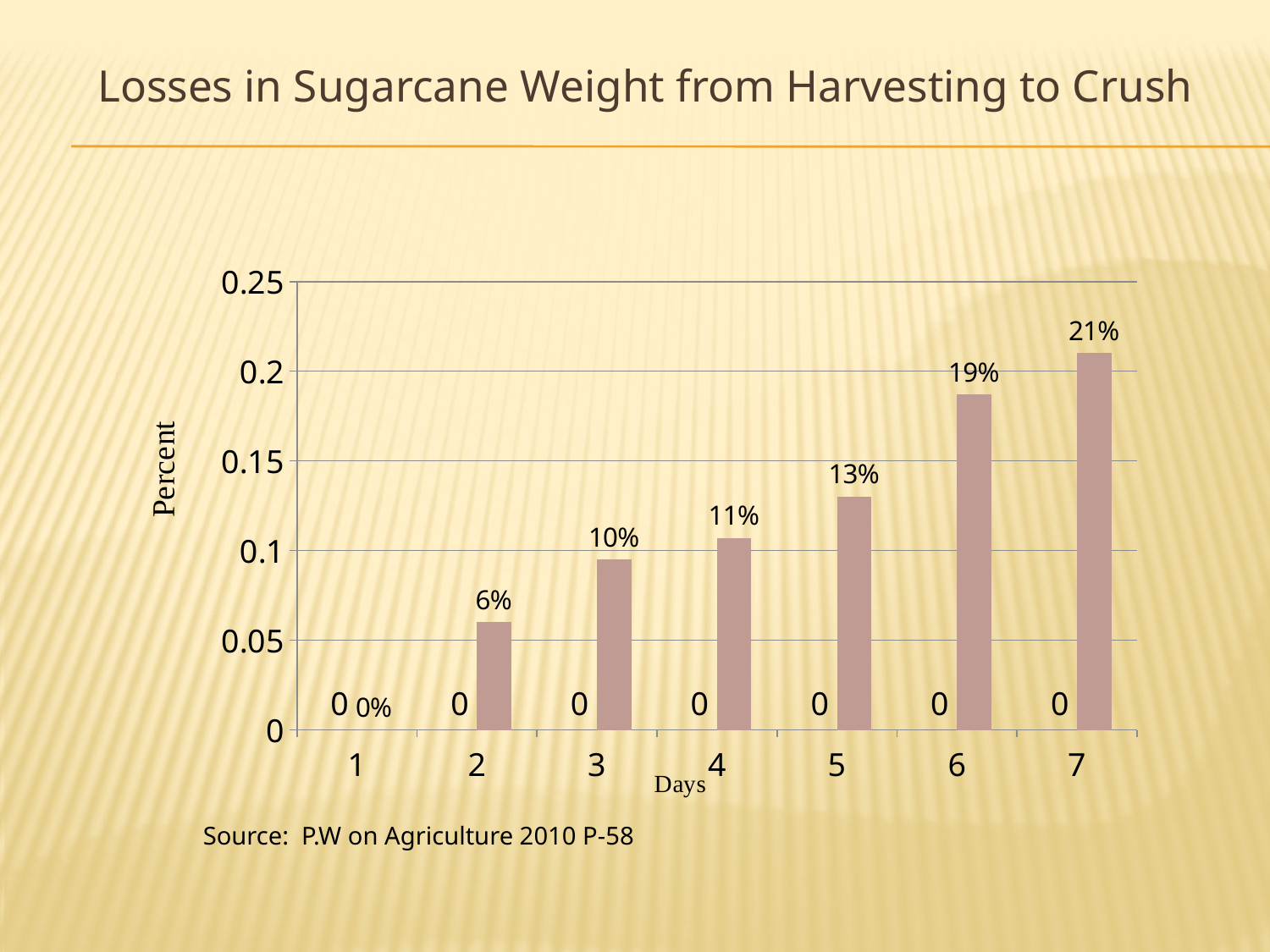
What is the difference in weight loss between day 6 and day 3? 9% Which day has the lowest weight loss percentage? 1 How many days are shown on the x axis of the chart? 7 What is the difference in weight loss between day 7 and day 6? 2% Which day has the highest weight loss percentage? 7 Do the weight loss values rise or fall as the number of days increases? rise What type of chart is shown on the slide? bar chart What is the weight loss percentage shown for day 5? 13% What is the weight loss percentage shown for day 7? 21% What is the weight loss percentage shown for day 2? 6% Which day shows a larger weight loss, day 4 or day 6? 6 What is the weight loss percentage shown for day 1? 0%